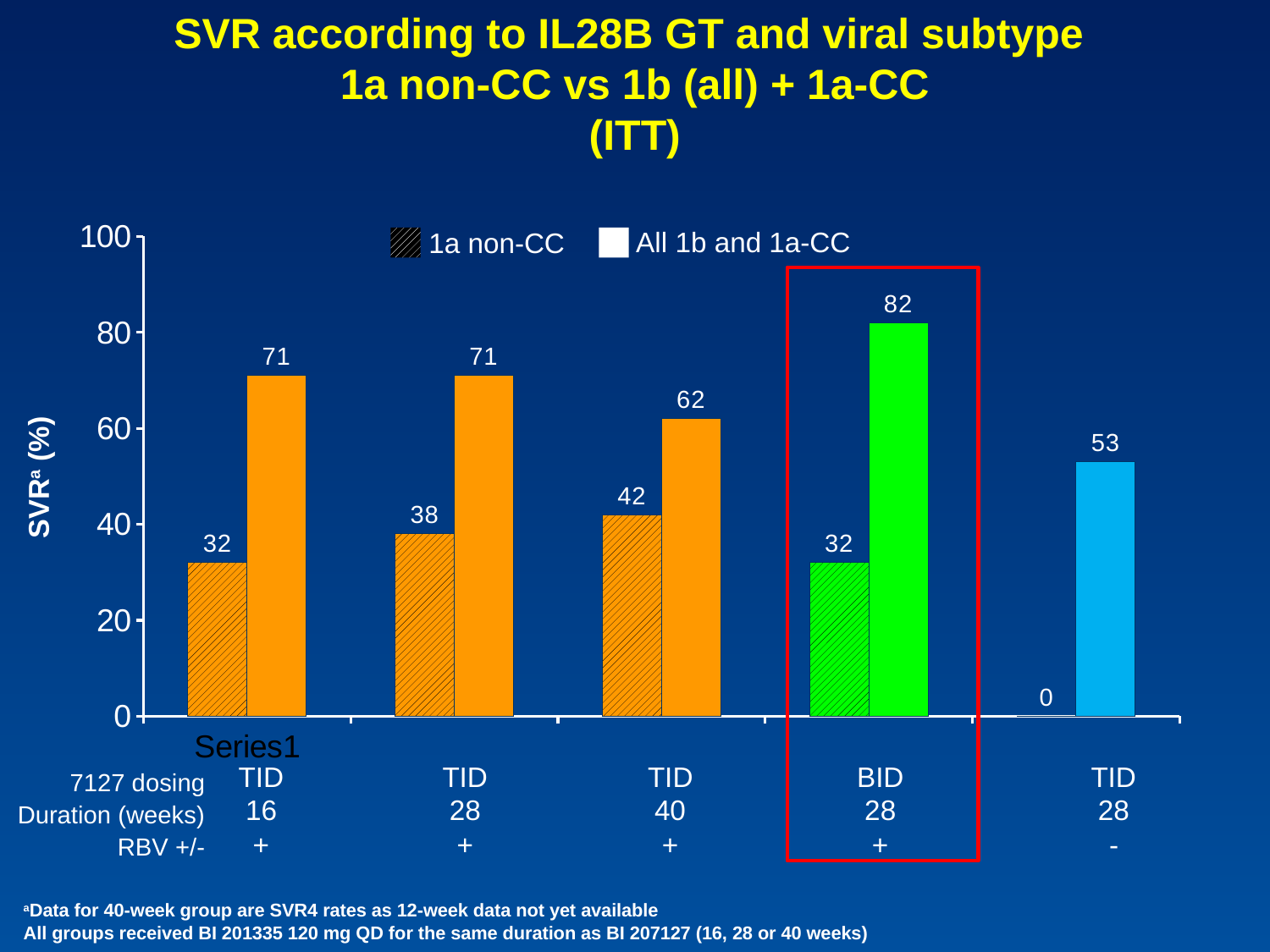
What is the SVR (%) for All 1b and 1a-CC in the TID 40-week RBV+ group? 62 Which group has the highest SVR (%) for All 1b and 1a-CC? BID 28 weeks RBV+ How many series does the legend list? 2 What is the SVR (%) for 1a non-CC in the TID 28-week RBV- group? 0 What is the SVR (%) for 1a non-CC in the TID 16-week RBV+ group? 32 Which group has the lowest SVR (%) for 1a non-CC? TID 28 weeks RBV- What is the difference between the All 1b and 1a-CC value and the 1a non-CC value in the BID 28-week RBV+ group? 50 In the TID 40-week RBV+ group, which is larger: the 1a non-CC value or the All 1b and 1a-CC value? All 1b and 1a-CC What is the SVR (%) for All 1b and 1a-CC in the BID 28-week RBV+ group? 82 What kind of chart is shown on the slide? bar chart Which group on the chart is outlined with a red box? BID 28 weeks RBV+ How many dosing groups are plotted along the x axis? 5